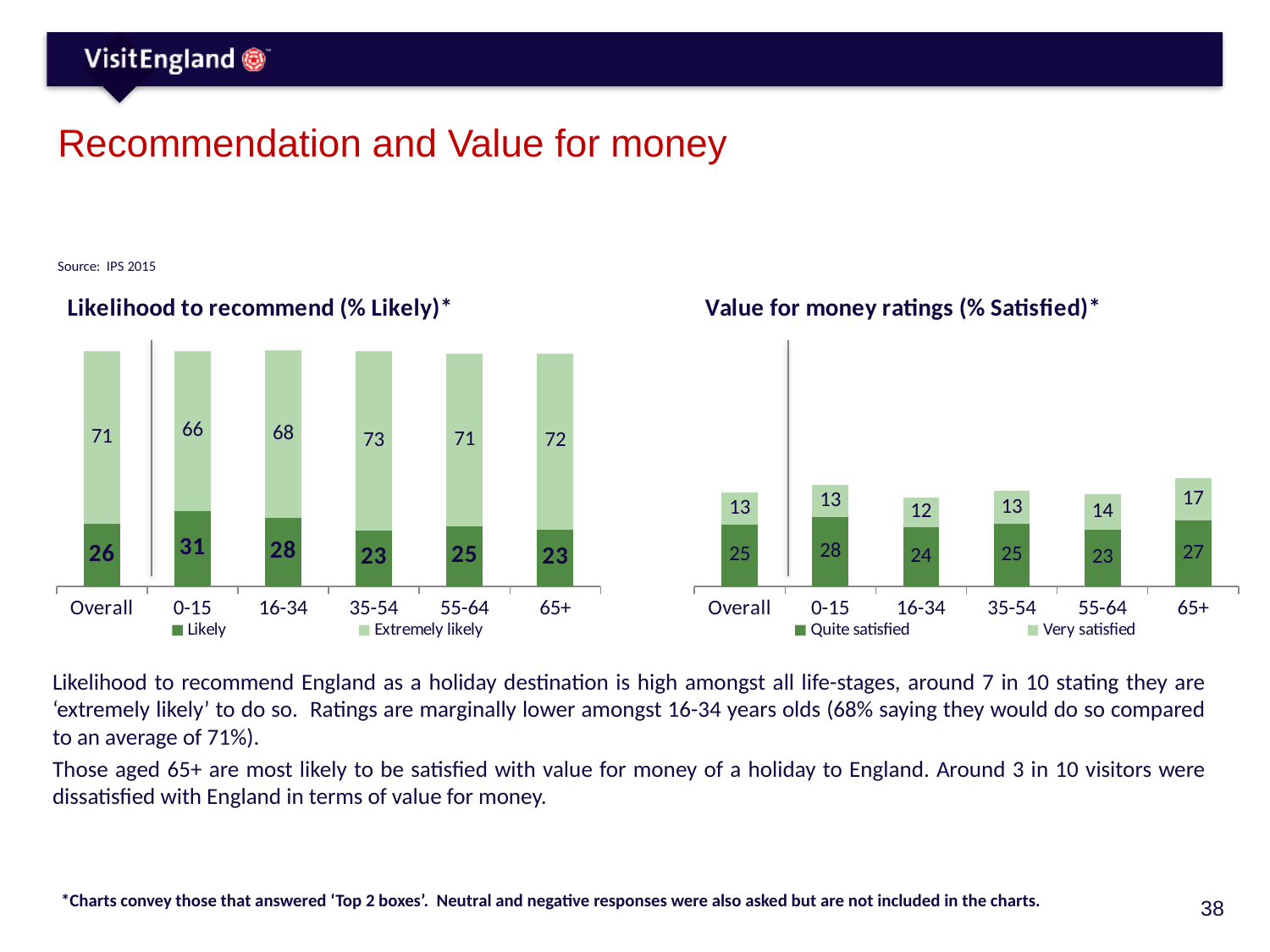
In the 'Value for money ratings (% Satisfied)' chart, what is the total of the stacked bar for 65+? 44 In the 'Likelihood to recommend (% Likely)' chart, which category has the lowest 'Extremely likely' value? 0-15 In the 'Likelihood to recommend (% Likely)' chart, what is the 'Likely' value for the 0-15 age group? 31 In the 'Likelihood to recommend (% Likely)' chart, what is the difference between the 'Extremely likely' values for 35-54 and 0-15? 7 In the 'Likelihood to recommend (% Likely)' chart, which age group has the highest 'Likely' value? 0-15 In the 'Value for money ratings (% Satisfied)' chart, which age group has the lowest 'Quite satisfied' value? 55-64 How many series does the legend of the 'Value for money ratings (% Satisfied)' chart list? 2 In the 'Likelihood to recommend (% Likely)' chart, what is the total of the stacked bar for Overall? 97 In the 'Value for money ratings (% Satisfied)' chart, is the 'Quite satisfied' value larger for 0-15 or for 16-34? 0-15 What type of chart is the 'Likelihood to recommend (% Likely)' chart? Stacked bar chart In the 'Value for money ratings (% Satisfied)' chart, what is the 'Very satisfied' value for the 65+ age group? 17 In the 'Likelihood to recommend (% Likely)' chart, what is the 'Extremely likely' value for the 35-54 age group? 73